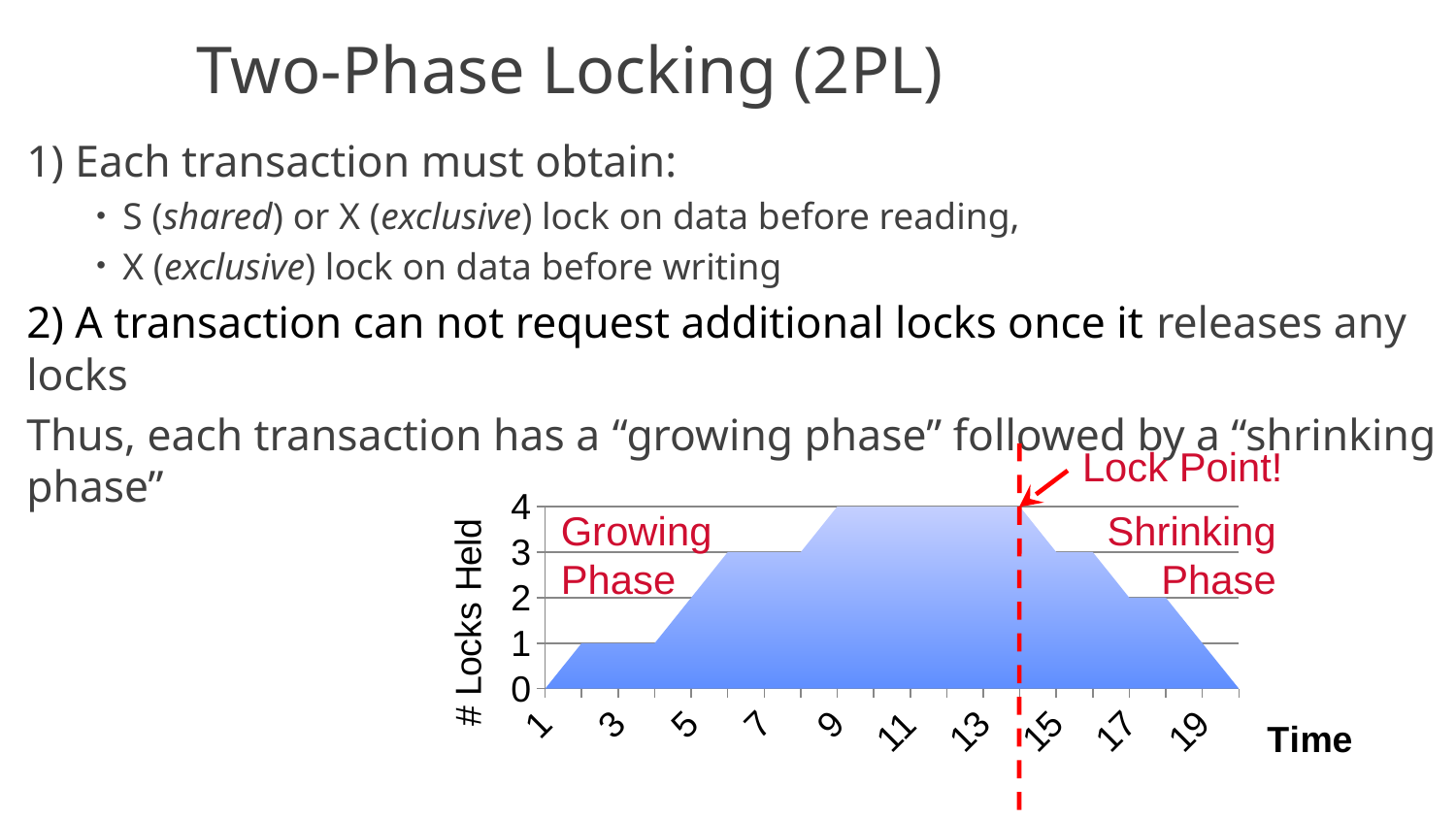
What is the label of the horizontal axis of the chart? Time How many locks are held at time 3? 1 What is the maximum number of locks held shown in the chart? 4 What is the label of the vertical axis of the chart? # Locks Held What kind of chart is shown on the slide? area chart Which time has more locks held, time 7 or time 17? time 7 Is the number of locks held at time 13 greater or less than 2? greater How many locks are held at time 17? 2 How many tick labels are shown on the Time axis? 10 How does the number of locks held change over time in the chart? rises, then falls How many locks are held at time 11? 4 How many locks are held at time 7? 3